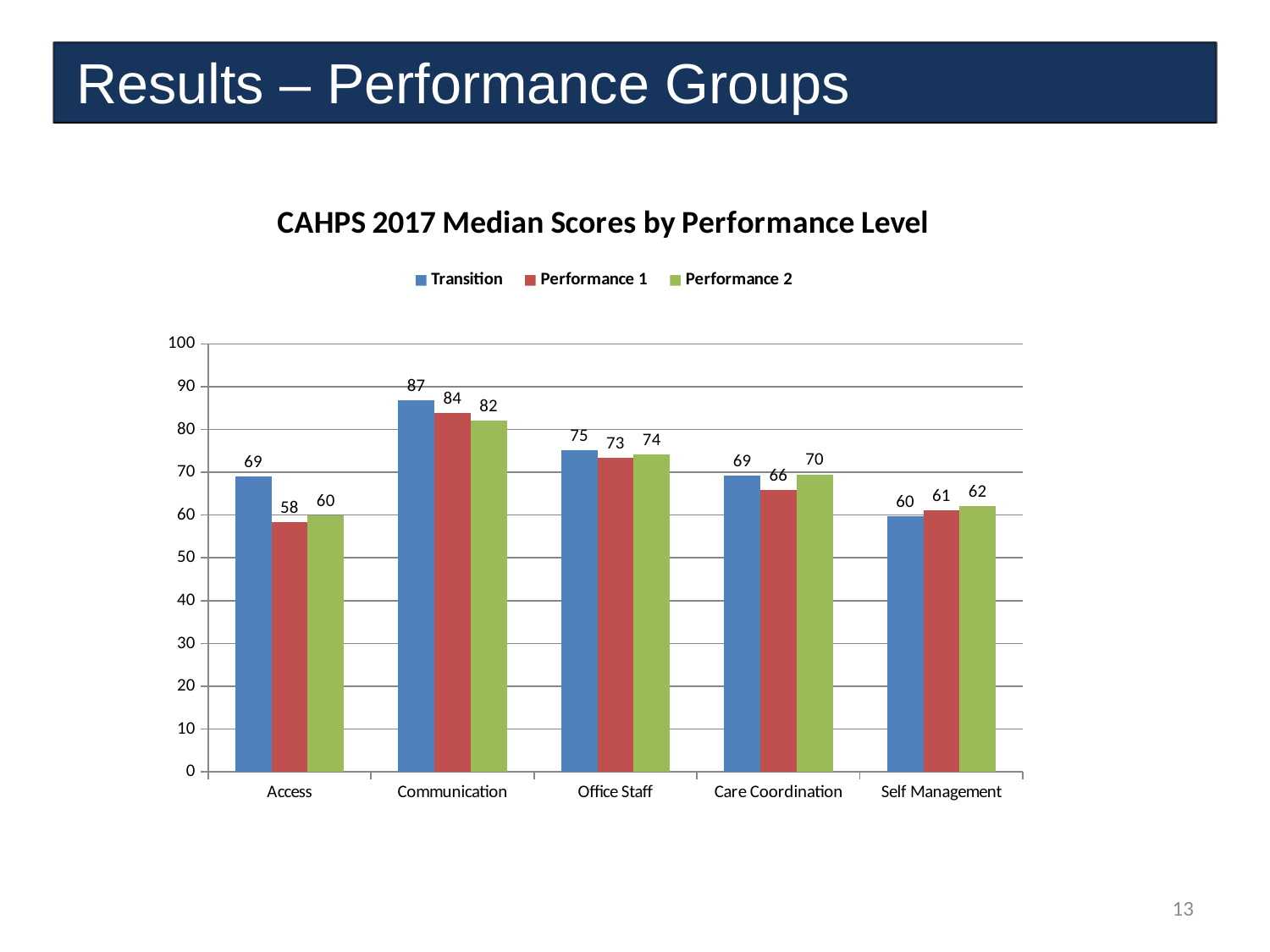
Which category has the highest Transition score? Communication What kind of chart is shown on the slide? bar chart How many categories are shown on the x axis? 5 Is the Performance 2 score for Communication greater or less than 80? greater How many series does the legend list? 3 What is the Transition score for Communication? 87 What is the Performance 2 score for Care Coordination? 70 What is the difference between the Transition and Performance 1 scores for Access? 11 Which is larger for Care Coordination, the Transition score or the Performance 2 score? Performance 2 What is the Performance 1 score for Access? 58 What is the title of the chart? CAHPS 2017 Median Scores by Performance Level Which category has the lowest Performance 1 score? Access